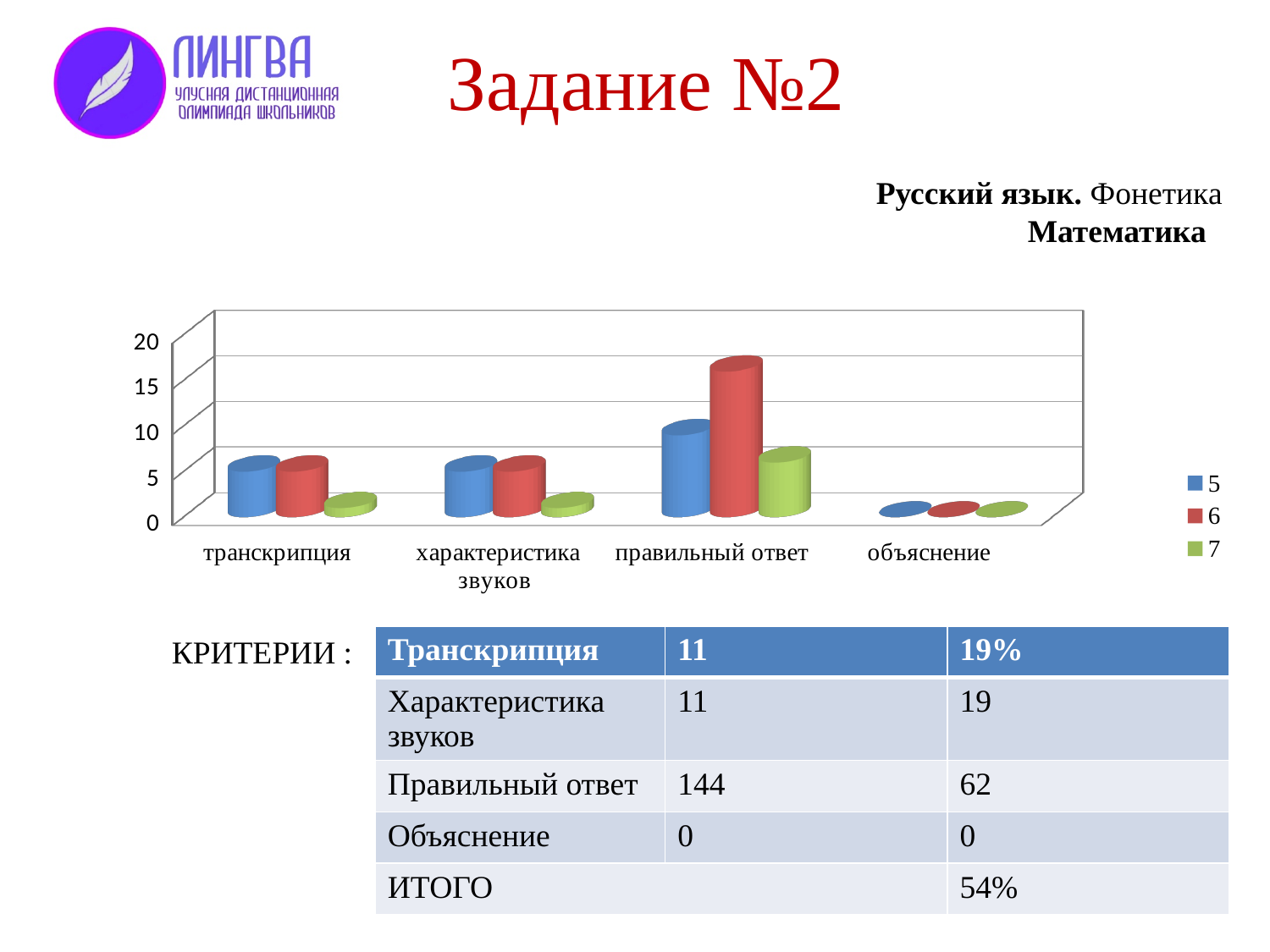
Which series has the highest value in the category правильный ответ? 6 How many series does the chart's legend list? 3 What kind of chart is shown on the slide? bar chart Which category has the highest value for series 6? правильный ответ What is the value for series 5 in the category объяснение? 0 How many categories are shown on the x axis of the chart? 4 What are the series names listed in the chart's legend? 5, 6, 7 Is the value for series 7 in the category правильный ответ greater or less than 10? less Which colour represents series 6 in the chart? red Is the value for series 6 in the category правильный ответ greater or less than 10? greater In the category транскрипция, which is larger: the value for series 5 or series 7? 5 Which category has the lowest values across all series? объяснение